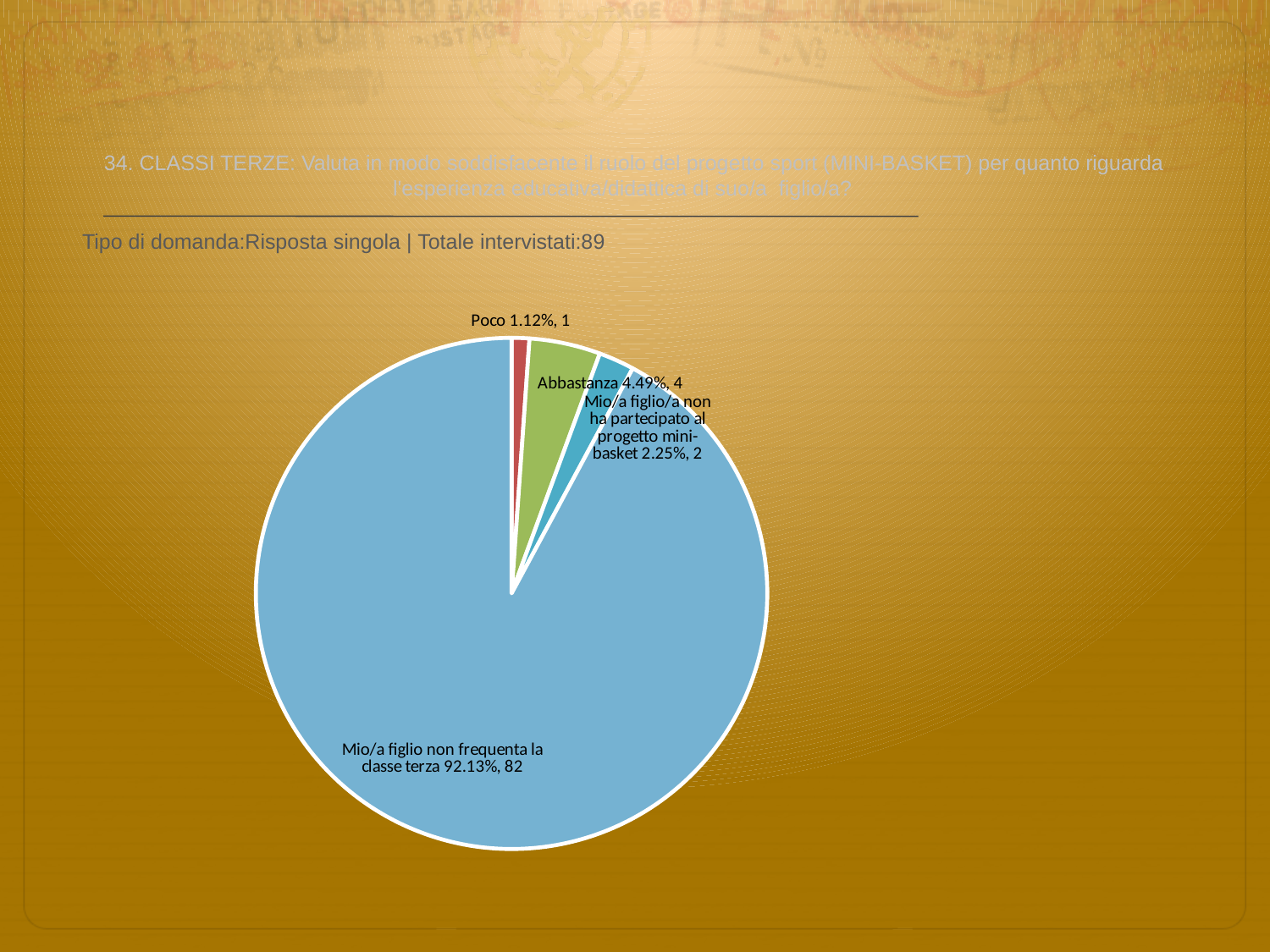
Which category has the smallest slice of the pie? Poco What percentage share does the 'Abbastanza' slice have? 4.49% Which category has the largest slice of the pie? Mio/a figlio non frequenta la classe terza What is the total number of respondents (Totale intervistati) stated on the slide? 89 How many respondents answered 'Abbastanza'? 4 How many slices does the pie chart have? 4 How many respondents are in the 'Mio/a figlio/a non ha partecipato al progetto mini-basket' slice? 2 Which is larger, the count for 'Abbastanza' or the count for 'Mio/a figlio/a non ha partecipato al progetto mini-basket'? Abbastanza What kind of chart is shown on the slide? pie chart What percentage share does the 'Mio/a figlio non frequenta la classe terza' slice have? 92.13% What percentage share does the 'Poco' slice have? 1.12% What is the difference in respondent count between 'Mio/a figlio non frequenta la classe terza' and 'Abbastanza'? 78